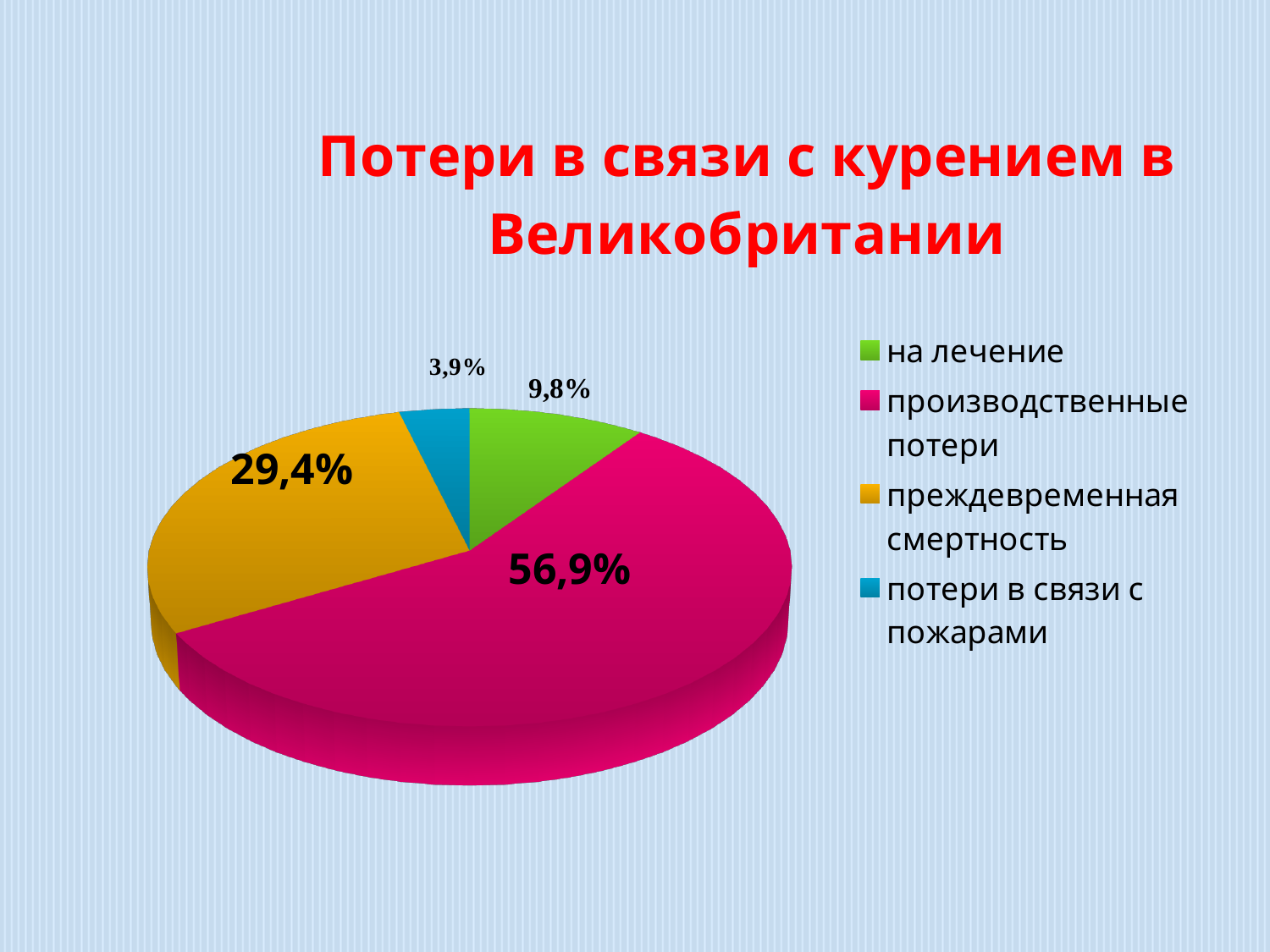
How many slices does the pie chart have? 4 What kind of chart is shown on the slide? pie chart What is the title of the chart on the slide? Потери в связи с курением в Великобритании Which is larger: the share for "на лечение" or the share for "потери в связи с пожарами"? на лечение Which category has the smallest slice of the pie? потери в связи с пожарами Which colour represents "преждевременная смертность" in the legend? orange What share of the pie is labelled for "преждевременная смертность"? 29,4% What share of the pie is labelled for "производственные потери"? 56,9% Which category has the largest slice of the pie? производственные потери What share of the pie is labelled for "на лечение"? 9,8% What share of the pie is labelled for "потери в связи с пожарами"? 3,9% What is the difference between the shares for "производственные потери" and "преждевременная смертность"? 27,5%